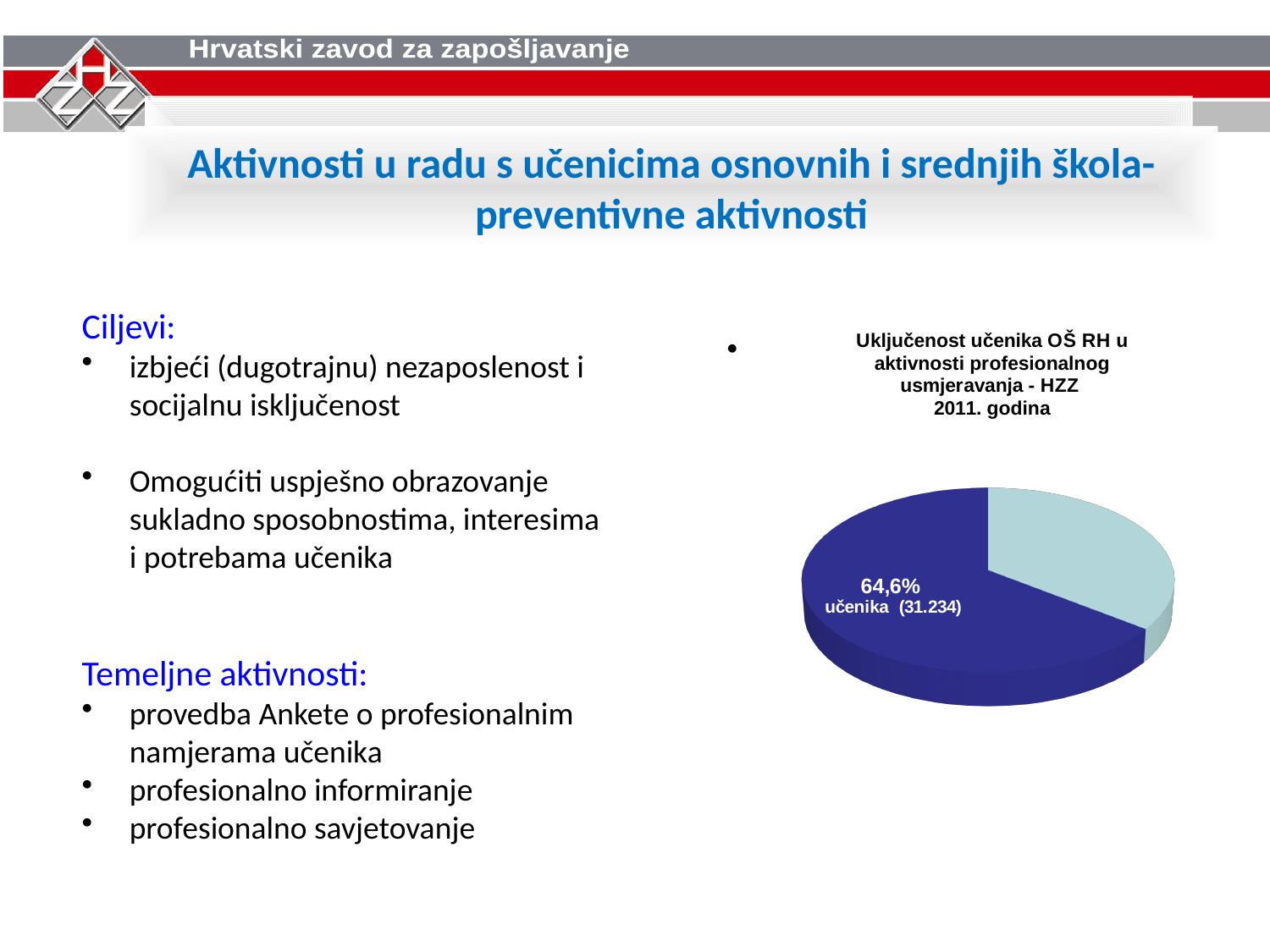
Is the share of the dark blue slice of the pie chart greater or less than 50%? greater What is the title of the pie chart? Uključenost učenika OŠ RH u aktivnosti profesionalnog usmjeravanja - HZZ 2011. godina What kind of chart is shown on the slide? pie chart How many students does the labelled slice of the pie chart represent? 31.234 Which slice of the pie chart is larger, the dark blue one or the light blue one? the dark blue one How many slices does the pie chart have? 2 Is the share of the light blue slice of the pie chart greater or less than 50%? less Which year does the pie chart refer to, according to its title? 2011 What percentage of students is shown on the labelled slice of the pie chart? 64,6%